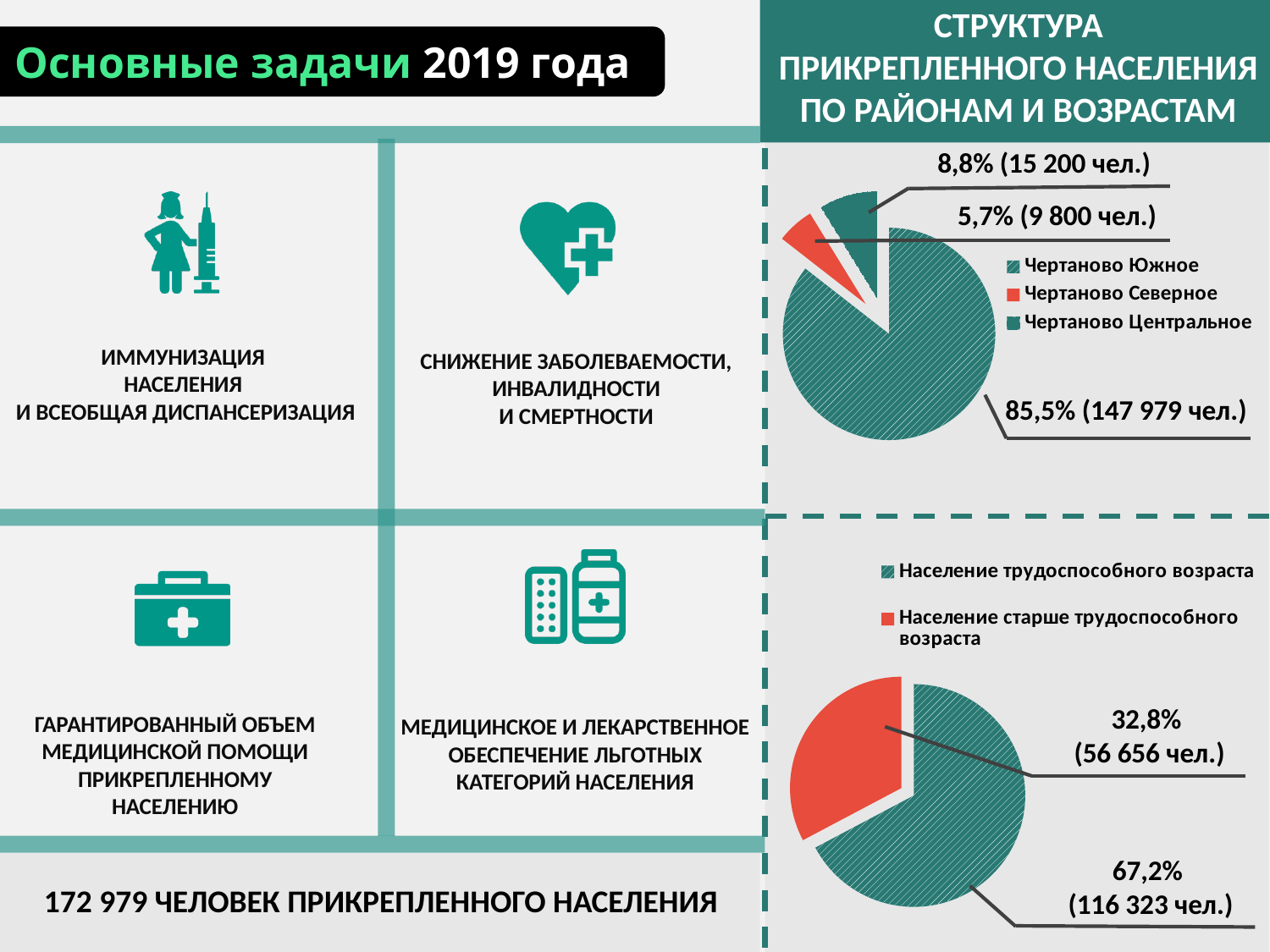
In the top pie chart (by district), how many people are attributed to Чертаново Центральное? 15 200 чел. In the top pie chart (by district), what share does Чертаново Северное have? 5,7% What kind of chart is the top chart on the right side of the slide (structure by district)? pie chart In the top pie chart (by district), what is the difference in percentage points between Чертаново Центральное and Чертаново Северное? 3,1 In the bottom pie chart (by age), what colour is the slice for the population older than working age? red In the top pie chart (by district), how many districts does the legend list? 3 In the bottom pie chart (by age), how many people are older than working age (старше трудоспособного возраста)? 56 656 чел. In the top pie chart (by district), which district has the smallest share? Чертаново Северное In the top pie chart (by district), what share does Чертаново Южное have? 85,5% In the bottom pie chart (by age), which group is larger: working age or older than working age? working age (трудоспособного возраста) In the bottom pie chart (by age), what share is the population of working age (трудоспособного возраста)? 67,2% In the top pie chart (by district), which district has the largest share? Чертаново Южное